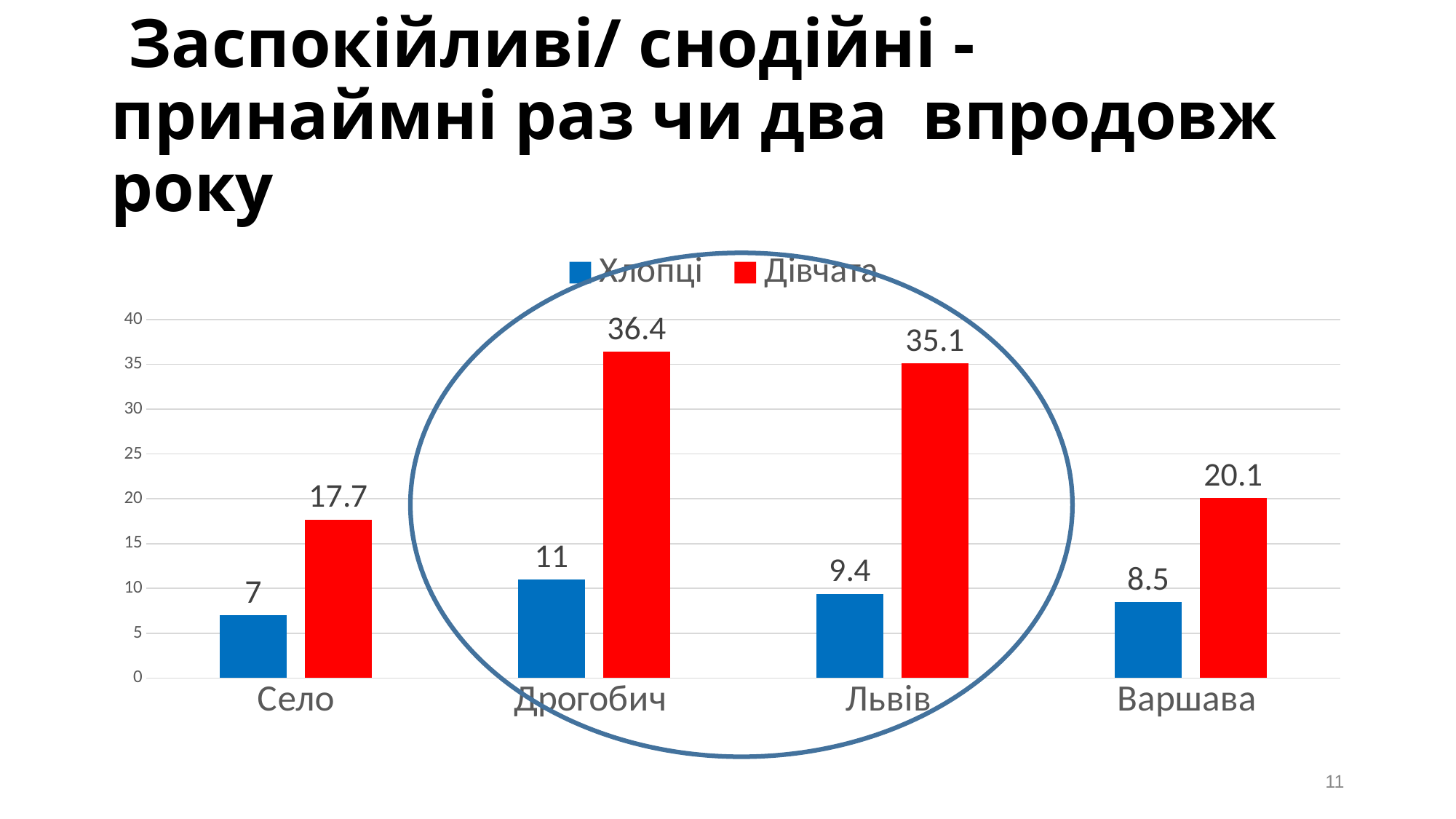
Which category has the highest value for Дівчата? Дрогобич How many categories are shown on the x axis? 4 Which colour represents the Дівчата series? red How many series does the legend list? 2 What is the value for Дівчата in Село? 17.7 What is the value for Хлопці in Дрогобич? 11 What is the value for Дівчата in Варшава? 20.1 Which is larger: the Хлопці value in Дрогобич or the Хлопці value in Варшава? Дрогобич Is the value for Дівчата in Львів greater or less than 30? greater Which category has the lowest value for Хлопці? Село What is the difference between the Дівчата and Хлопці values in Львів? 25.7 What kind of chart is shown on the slide? bar chart